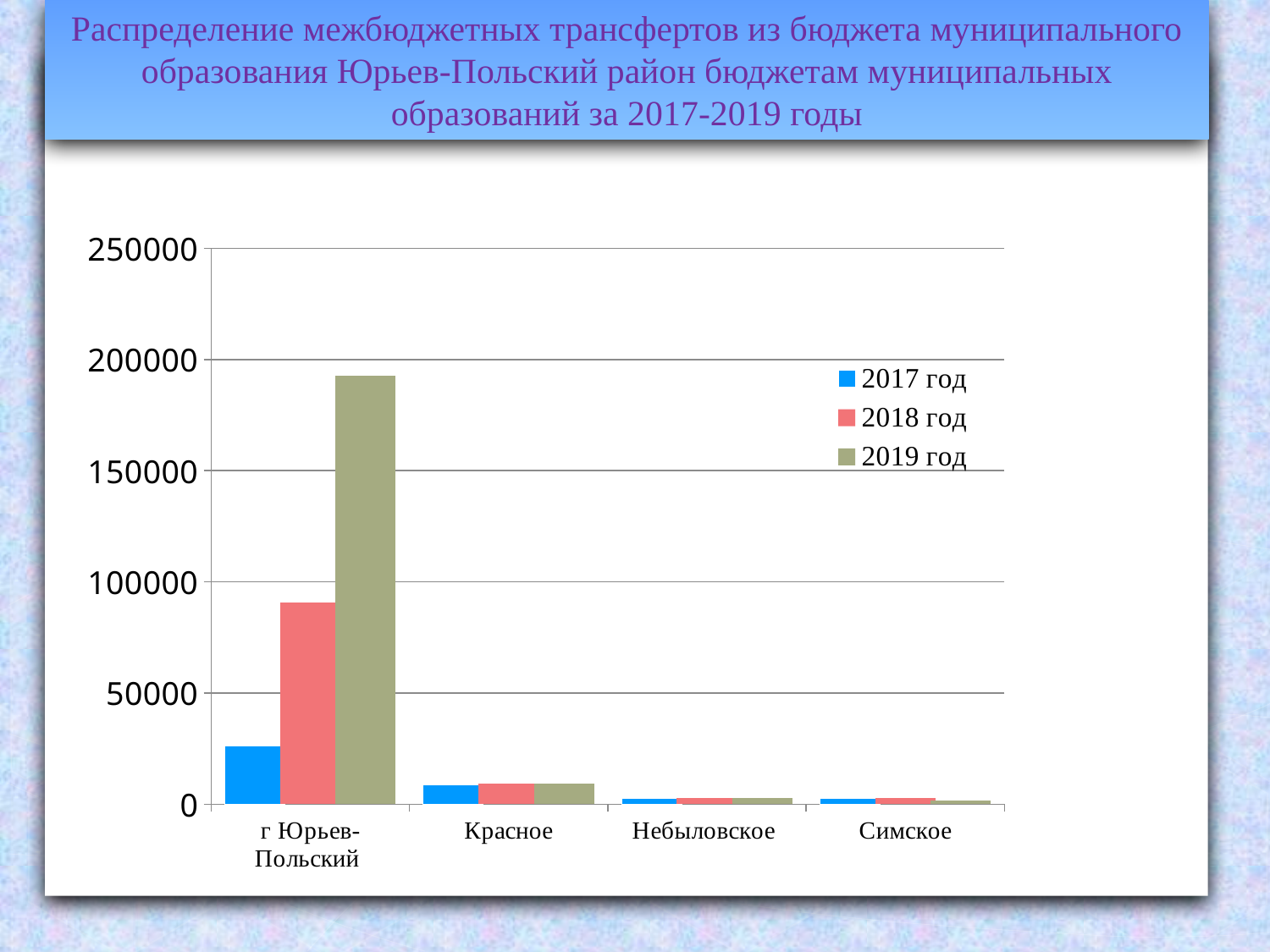
Is the 2017 год value for г Юрьев-Польский greater or less than 50000? less How many categories are shown on the x axis of the chart? 4 For г Юрьев-Польский, do the values rise or fall from 2017 год to 2019 год? rise Which series has the highest value for г Юрьев-Польский? 2019 год Is the 2018 год value for г Юрьев-Польский greater or less than 100000? less Which category has the tallest bar in the chart? г Юрьев-Польский What kind of chart is shown on the slide? bar chart Is the 2019 год value for г Юрьев-Польский greater or less than 150000? greater Which is larger: the 2019 год value for Красное or the 2019 год value for Небыловское? Красное For г Юрьев-Польский, which is larger: the 2017 год value or the 2019 год value? 2019 год What colour represents the 2018 год series in the legend? red How many series does the legend list? 3